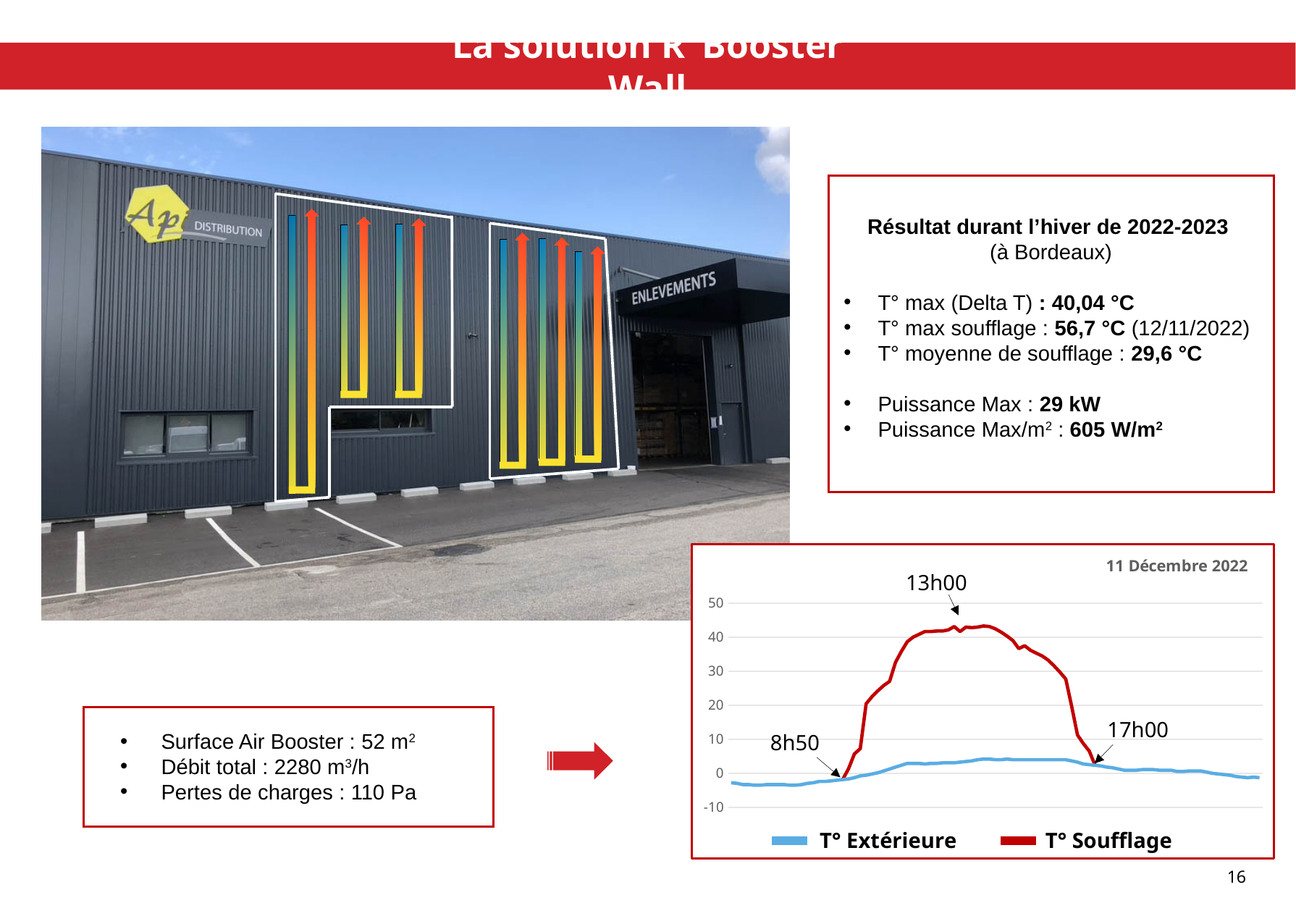
What kind of chart is shown on the slide? line chart What are the two series named in the chart's legend? T° Extérieure and T° Soufflage Does T° Soufflage rise or fall between 8h50 and 13h00? rise Does T° Soufflage rise or fall between 13h00 and 17h00? fall Is the value of T° Soufflage at 13h00 greater or less than 30? greater How many time points are annotated with arrows on the chart? 3 Which series is higher at 13h00, T° Extérieure or T° Soufflage? T° Soufflage What date is shown in the top-right corner of the chart? 11 Décembre 2022 How many series does the chart's legend list? 2 Is the value of T° Extérieure at 13h00 greater or less than 10? less What is the highest value shown on the chart's vertical axis? 50 Is the value of T° Soufflage at 8h50 greater or less than 10? less